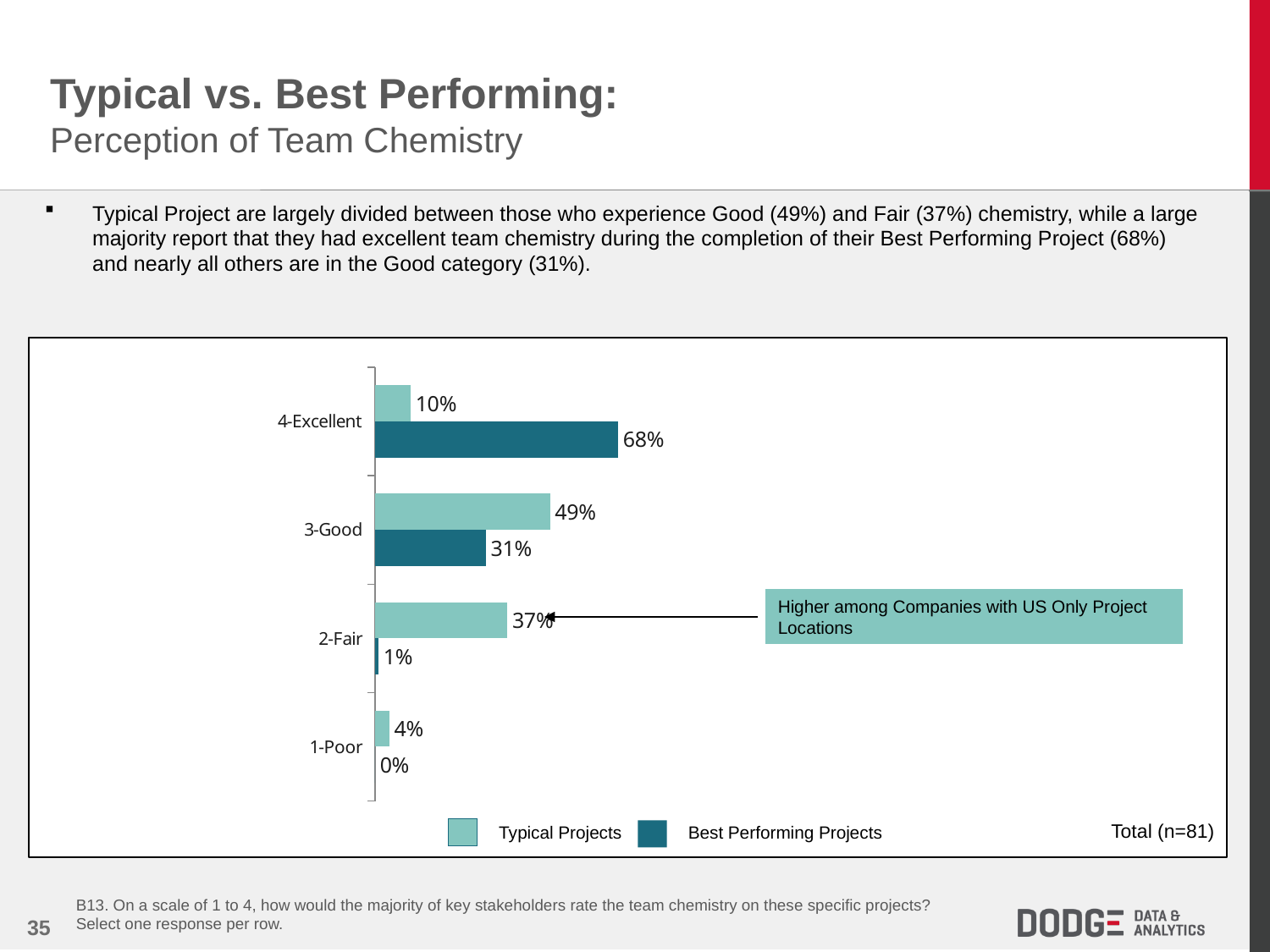
What is the value for Best Performing Projects in the 2-Fair category? 1% What percentage of Best Performing Projects are rated 4-Excellent for team chemistry? 68% How many rating categories are shown on the chart? 4 Which category has the highest value for Best Performing Projects? 4-Excellent What is the difference between Best Performing Projects and Typical Projects in the 4-Excellent category? 58% Which is larger in the 3-Good category: Typical Projects or Best Performing Projects? Typical Projects What percentage of Typical Projects are rated 4-Excellent for team chemistry? 10% What is the value for Typical Projects in the 3-Good category? 49% Which category has the lowest value for Typical Projects? 1-Poor What is the sample size shown on the chart? n=81 How many series does the legend list? 2 What type of chart is shown on the slide? Bar chart